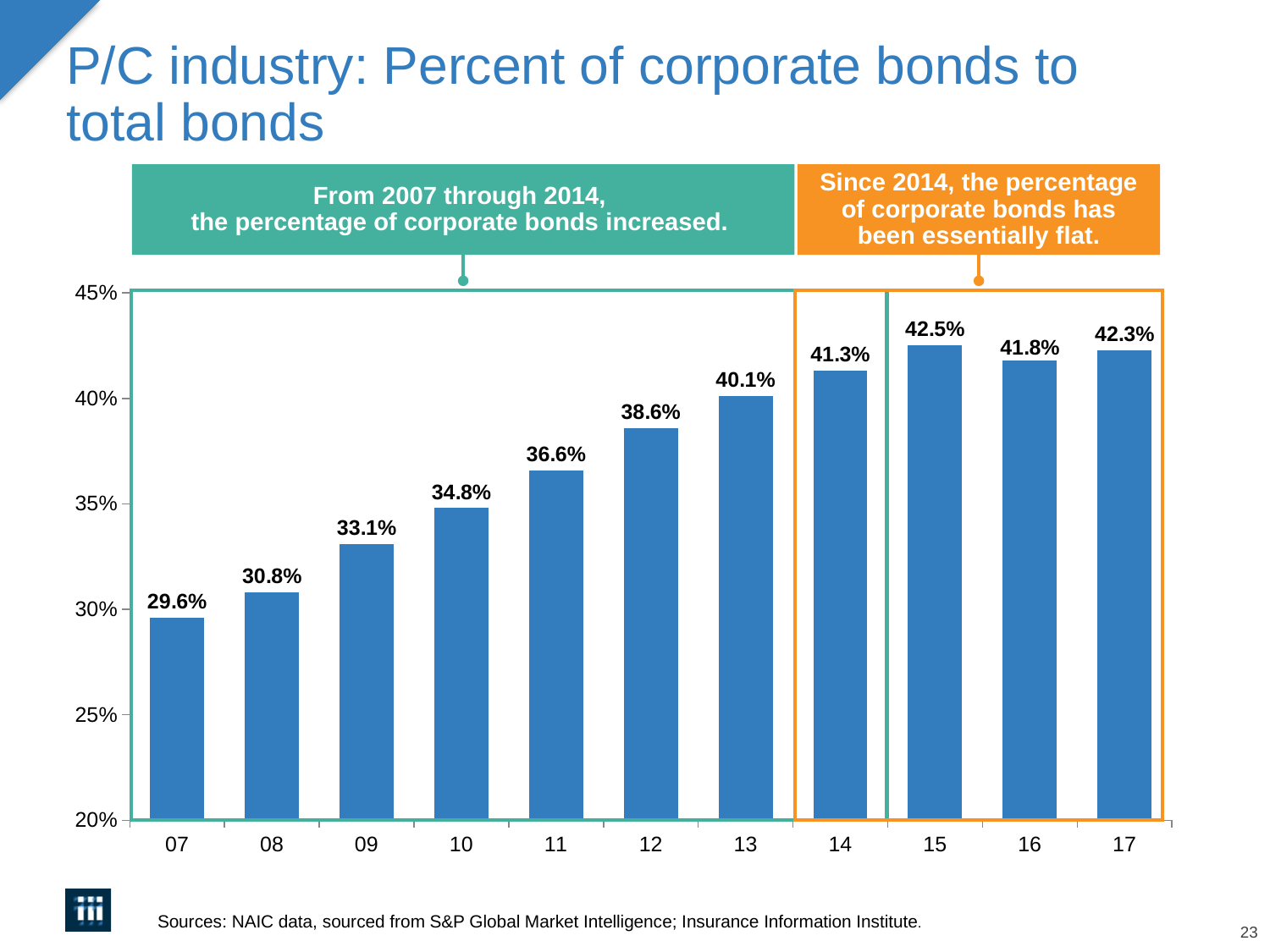
What kind of chart is shown on the slide? Bar chart What is the difference between the values for 2017 and 2007? 12.7% Which year has the lowest percentage of corporate bonds to total bonds? 07 Do the values rise or fall from 2007 through 2014? Rise How many years are shown on the x axis? 11 What value is shown for 2014? 41.3% What is the percent of corporate bonds to total bonds in 2010? 34.8% Which is larger, the value for 2012 or the value for 2013? 2013 Which year has the highest percentage of corporate bonds to total bonds? 15 What is the value for 2017? 42.3% What is the difference between the values for 2015 and 2016? 0.7% Is the value for 2011 greater or less than 35%? greater